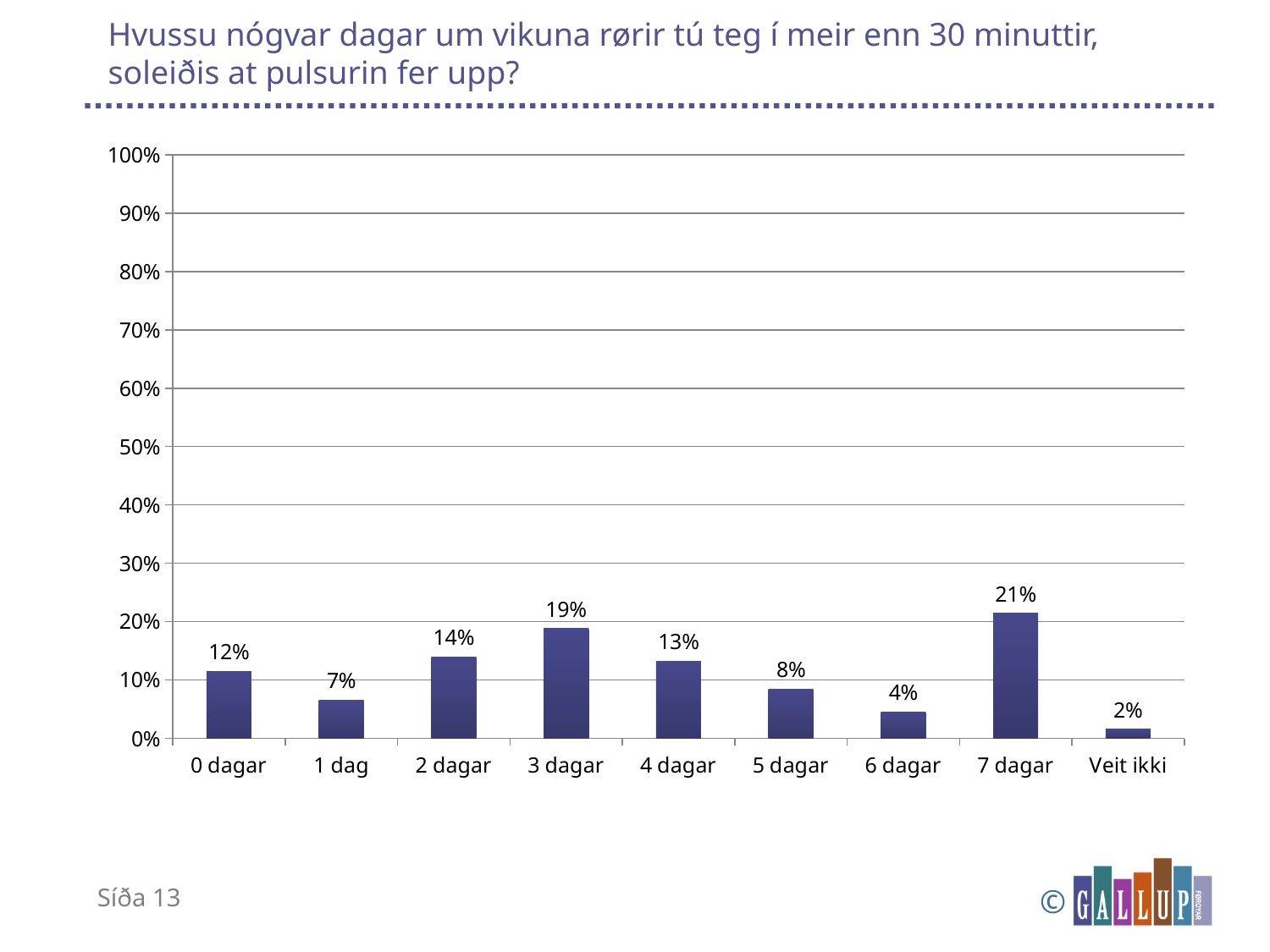
What is the value for 3 dagar? 19% What is the highest value shown on the y axis? 100% What is the difference between the values for 7 dagar and 6 dagar? 17% What is the value for Veit ikki? 2% Which is larger, the value for 2 dagar or the value for 4 dagar? 2 dagar What is the difference between the values for 3 dagar and 1 dag? 12% What kind of chart is shown on the slide? bar chart What is the value for 0 dagar? 12% Is the value for 7 dagar greater or less than 30%? less Which category has the highest value? 7 dagar How many categories are shown on the x axis? 9 Which category has the lowest value? Veit ikki